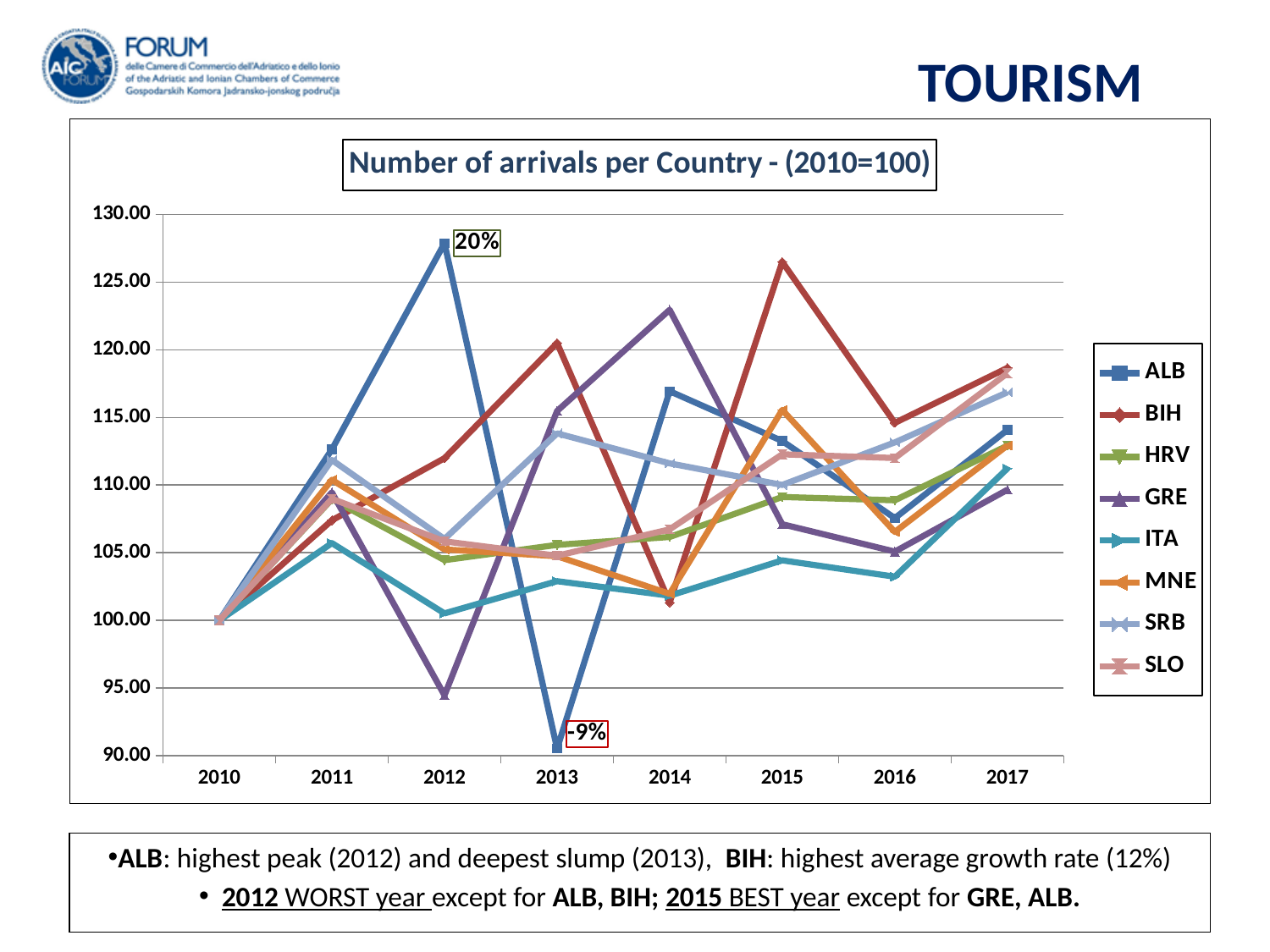
Which country has the highest value in 2015? BIH How many series does the legend list? 8 Which country has the lowest value in 2013? ALB Which country has the highest value in 2012? ALB Is the value for ALB in 2012 greater or less than 125? greater What is the title of the chart? Number of arrivals per Country - (2010=100) What is the value for ALB in 2010? 100.00 In 2015, which is larger, the value for BIH or the value for ITA? BIH Is the value for ALB in 2013 greater or less than 95? less What kind of chart is shown on the slide? line chart Is the value for GRE in 2012 greater or less than 100? less How many years are shown on the x axis? 8